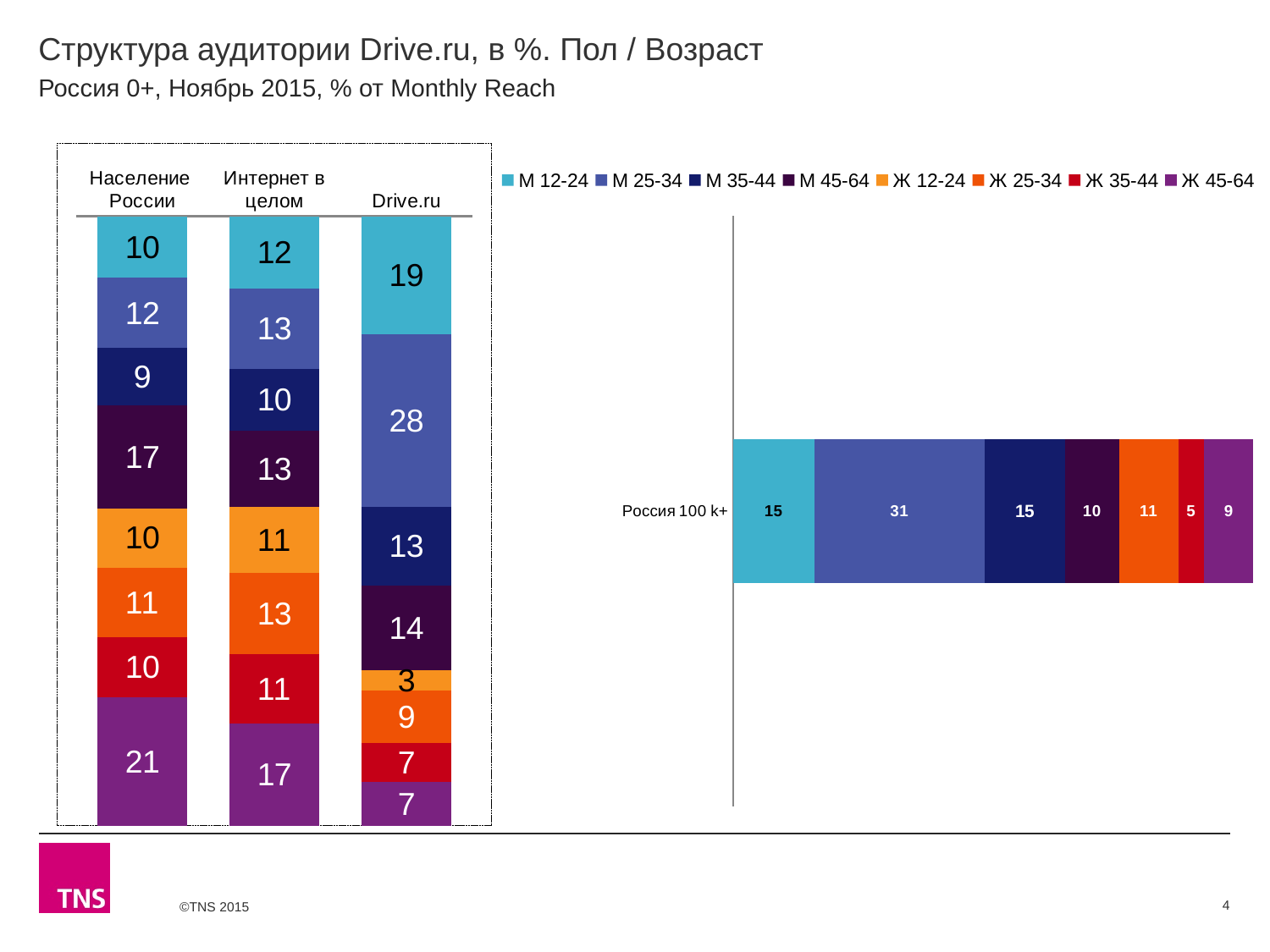
In the left chart, which segment of the Drive.ru bar is the smallest? Ж 12-24 In the left chart, what is the value of the Ж 45-64 segment for Население России? 21 In the left chart, what is the value of the М 45-64 segment for Интернет в целом? 13 In the left chart, what is the value of the М 25-34 segment for Drive.ru? 28 What kind of chart is the chart on the right (Россия 100 k+)? Stacked bar chart In the left chart, what is the difference between the М 12-24 values for Drive.ru and Население России? 9 In the right chart (Россия 100 k+), which segment is the largest? М 25-34 In the left chart, which is larger: the Ж 45-64 value for Население России or for Drive.ru? Население России In the right chart (Россия 100 k+), what is the value of the М 25-34 segment? 31 In the left chart, how many bars (audience groups) are shown? 3 In the left chart, which segment of the Drive.ru bar is the largest? М 25-34 How many series does the legend list? 8